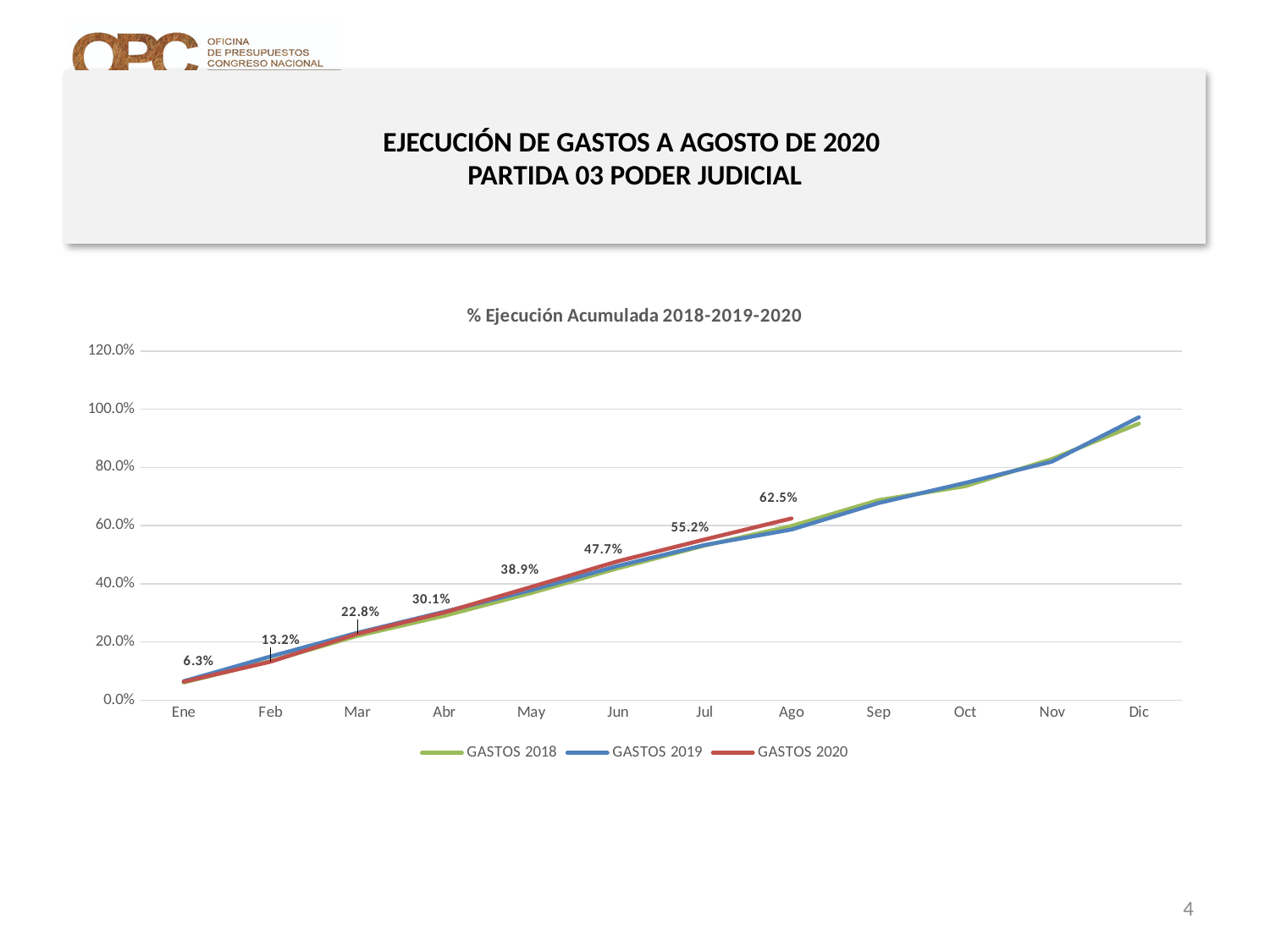
What is the value for GASTOS 2020 in Mar? 22.8% In which month does GASTOS 2020 reach its highest value? Ago What is the difference between the GASTOS 2020 values for Ago and Jul? 7.3% What is the difference between the GASTOS 2020 values for Feb and Ene? 6.9% What is the value for GASTOS 2020 in Ago? 62.5% Is the value for GASTOS 2019 in Dic greater or less than 80.0%? greater What is the value for GASTOS 2020 in Ene? 6.3% How many months are shown on the x axis? 12 What is the value for GASTOS 2020 in May? 38.9% How many series does the legend list? 3 What kind of chart is shown on the slide? line chart In which month is the GASTOS 2020 value lowest? Ene